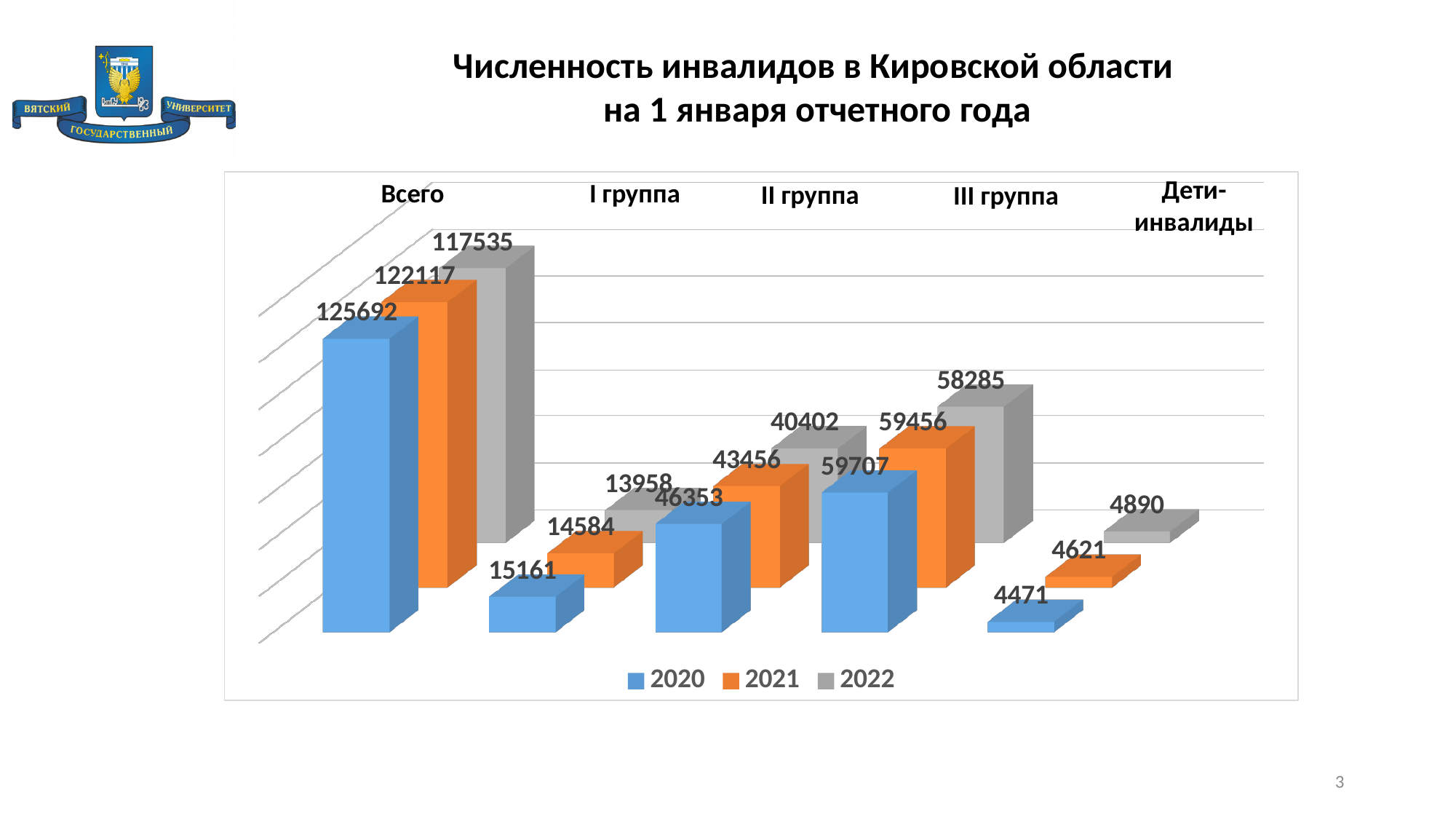
What is the value for III группа in 2021? 59456 Excluding Всего, which category has the highest value in 2022? III группа What is the value for II группа in 2022? 40402 What is the difference between the 2020 and 2022 values for Всего? 8157 Do the values for Дети-инвалиды rise or fall from 2020 to 2022? rise How many series does the legend list? 3 Which category has the lowest value in 2020? Дети-инвалиды Which is larger for II группа: the 2020 value or the 2021 value? 2020 What is the value for Всего in 2020? 125692 How many categories are shown on the x axis? 5 What is the value for Дети-инвалиды in 2021? 4621 What is the difference between the 2021 and 2022 values for I группа? 626